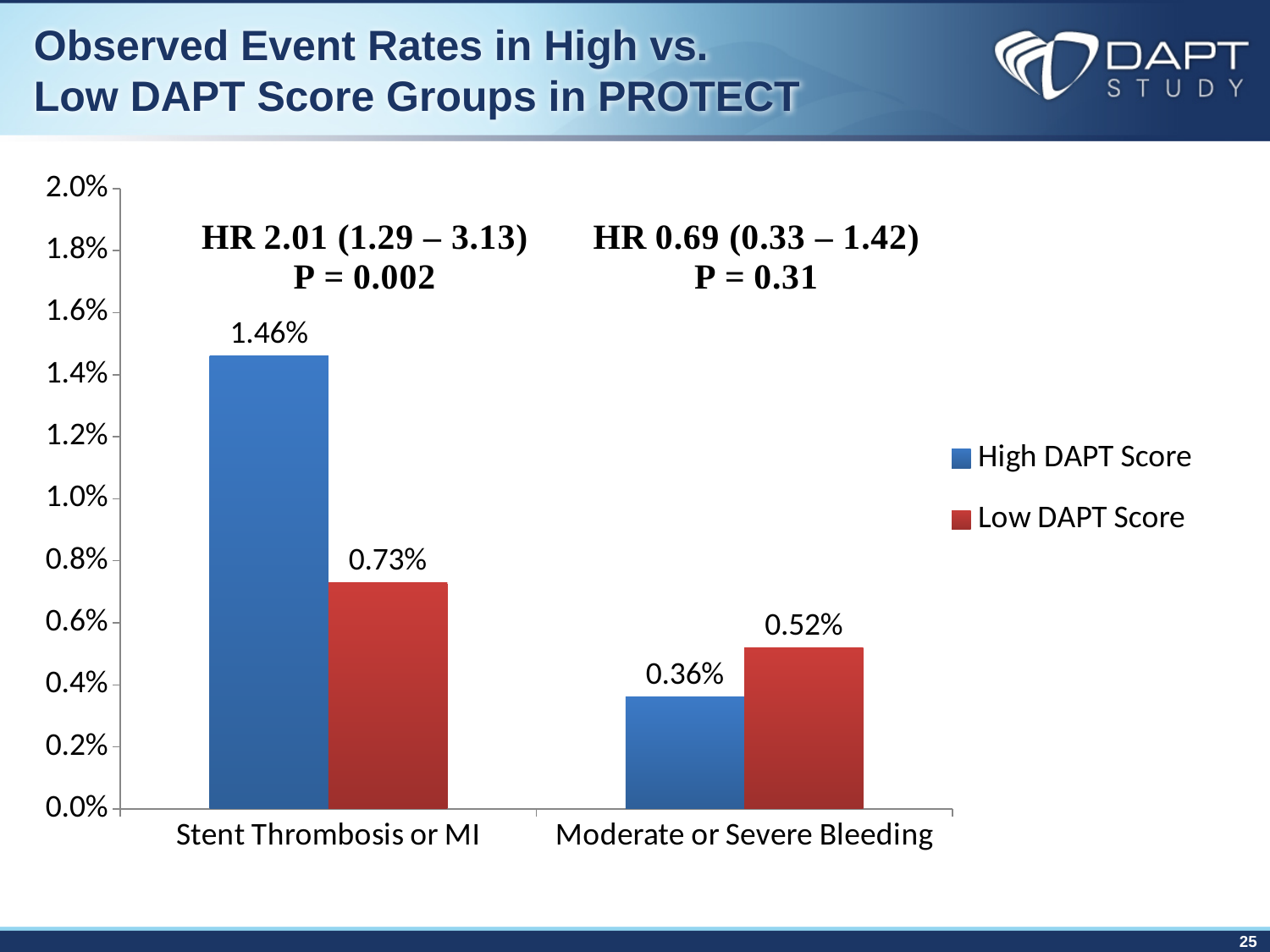
What is the value for High DAPT Score in the Moderate or Severe Bleeding category? 0.36% What kind of chart is shown on the slide? Bar chart What is the value for Low DAPT Score in the Moderate or Severe Bleeding category? 0.52% What is the difference between the High DAPT Score and Low DAPT Score values for Stent Thrombosis or MI? 0.73% Which bar has the lowest value on the chart? High DAPT Score, Moderate or Severe Bleeding What is the difference between the Low DAPT Score and High DAPT Score values for Moderate or Severe Bleeding? 0.16% How many categories are shown on the x axis? 2 For Moderate or Severe Bleeding, which series has the larger value, High DAPT Score or Low DAPT Score? Low DAPT Score How many series does the legend list? 2 What is the value for Low DAPT Score in the Stent Thrombosis or MI category? 0.73% Which bar has the highest value on the chart? High DAPT Score, Stent Thrombosis or MI What is the value for High DAPT Score in the Stent Thrombosis or MI category? 1.46%